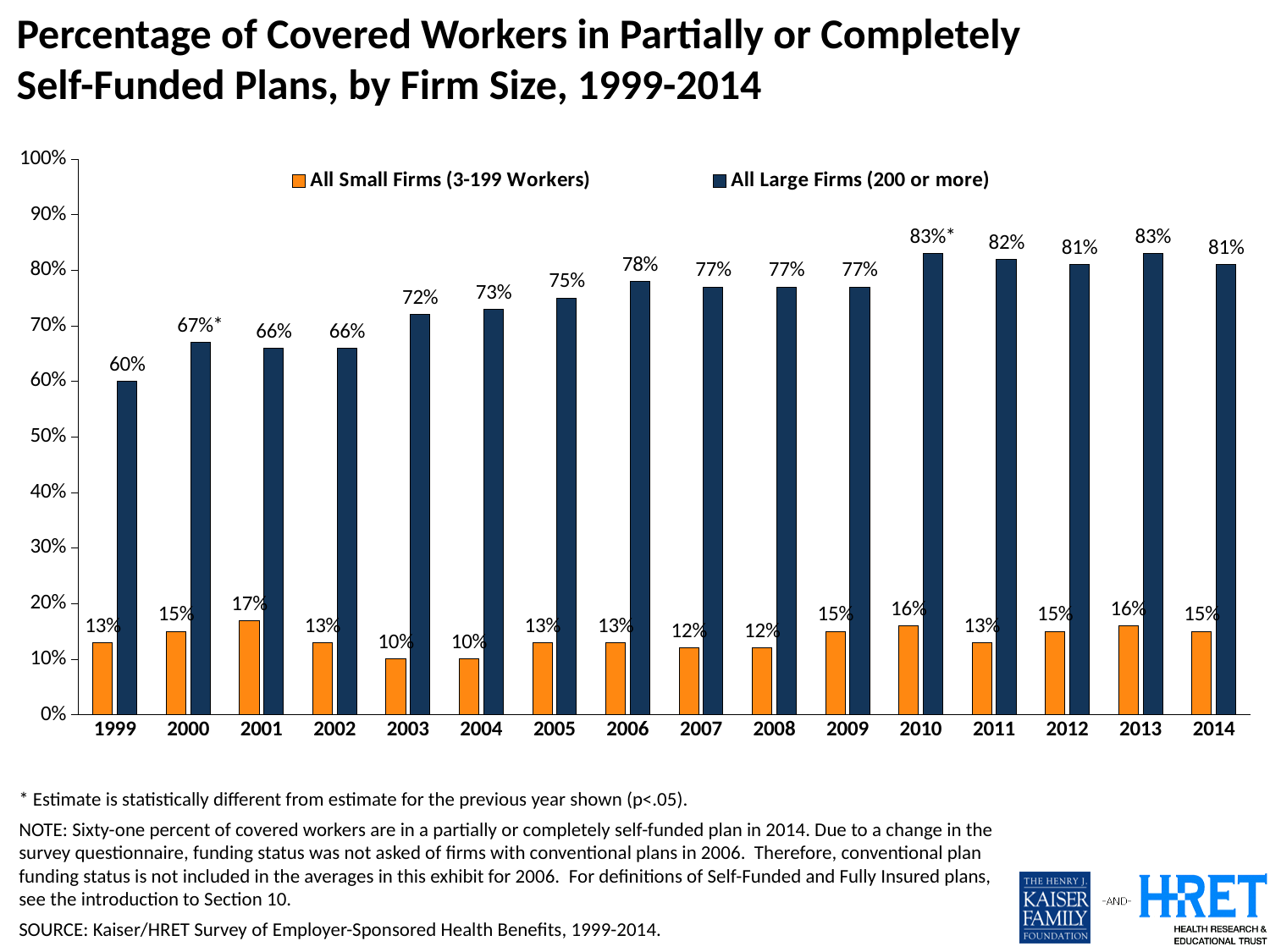
How many series does the legend list? 2 How many years are shown on the x axis? 16 What percentage of covered workers in all large firms (200 or more) were in self-funded plans in 1999? 60% Does the value for all large firms (200 or more) generally rise or fall from 1999 to 2014? Rise In which year is the value for all large firms (200 or more) lowest? 1999 What is the difference between the large-firm and small-firm values in 2014? 66 percentage points By how many percentage points did the value for all large firms (200 or more) change from 1999 to 2014? 21 percentage points In which year is the value for all small firms (3-199 workers) highest? 2001 What kind of chart is shown on the slide? Bar chart What is the value for all small firms (3-199 workers) in 2014? 15% Which is larger: the value for all small firms in 2001 or in 2003? 2001 What is the value for all large firms (200 or more) in 2006? 78%